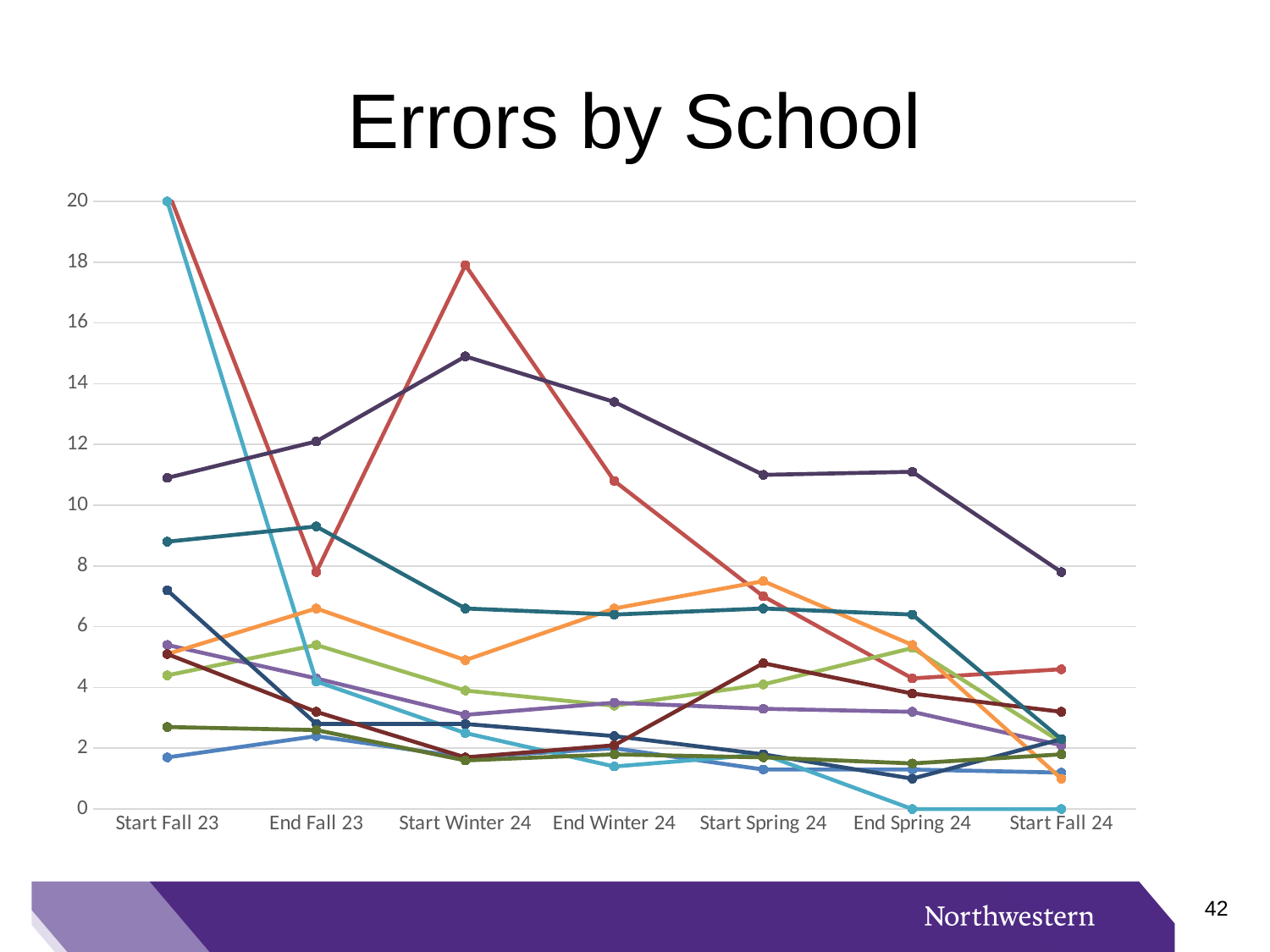
Is the highest value plotted at End Fall 23 greater or less than 14? less How many time points are shown along the x axis? 7 What kind of chart is shown on the slide? line chart What is the lowest value plotted at Start Fall 24? 0 What is the lowest value plotted at End Spring 24? 0 What is the title of the chart? Errors by School Is the highest value plotted at Start Winter 24 greater or less than 16? greater Is the highest value plotted at Start Fall 24 greater or less than 10? less What is the first category on the x axis? Start Fall 23 What is the maximum value shown on the y axis? 20